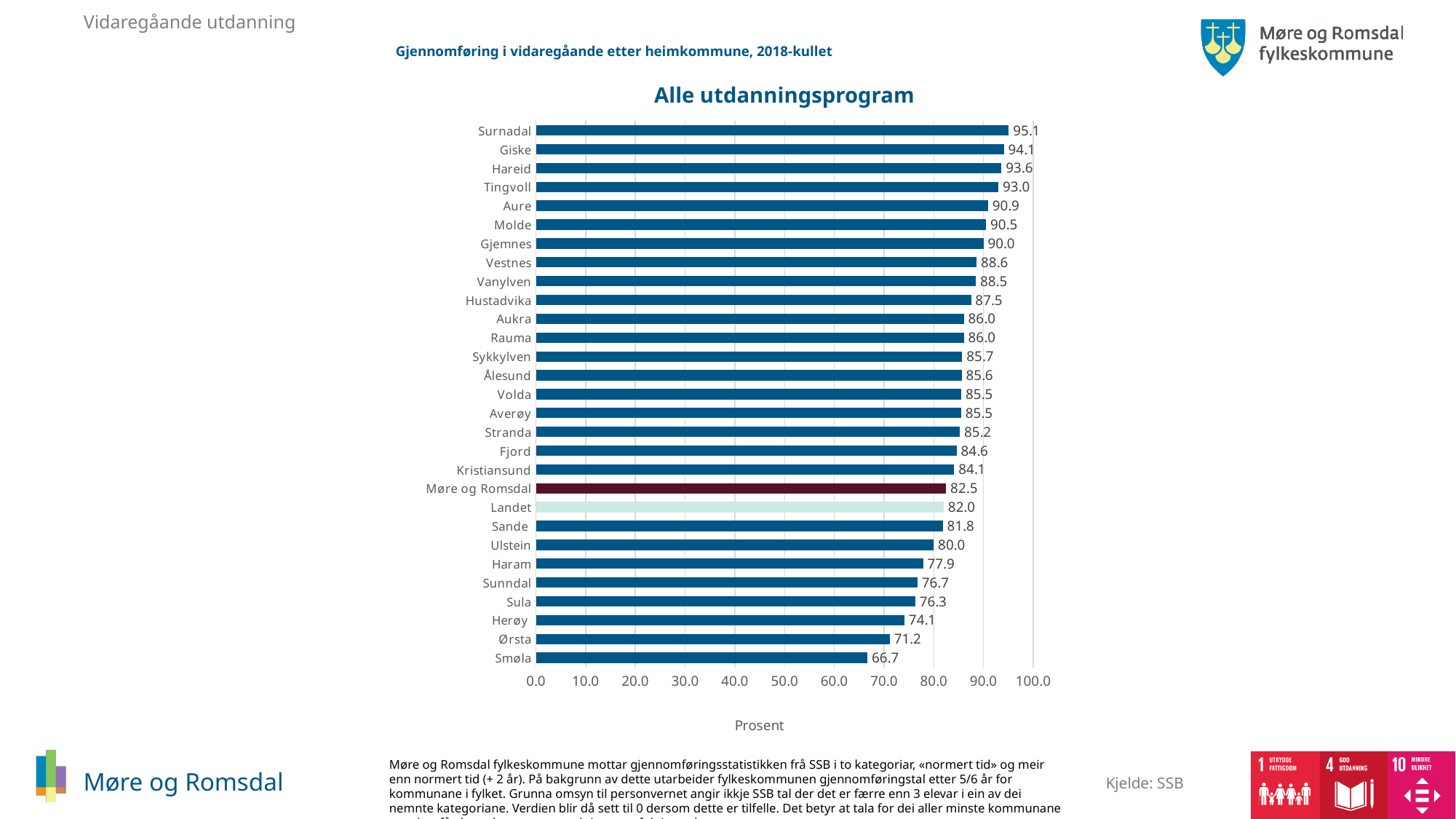
What kind of chart is shown on the slide? Bar chart What is the value for Landet? 82.0 Which category has the lowest value? Smøla What is the title of the chart? Alle utdanningsprogram What is the value for Surnadal? 95.1 What is the difference between the values for Surnadal and Smøla? 28.4 How many bars are shown in the chart? 29 Which has a larger value, Ålesund or Kristiansund? Ålesund Which category has the highest value? Surnadal What is the label of the horizontal axis? Prosent What is the value for Møre og Romsdal? 82.5 What is the value for Molde? 90.5